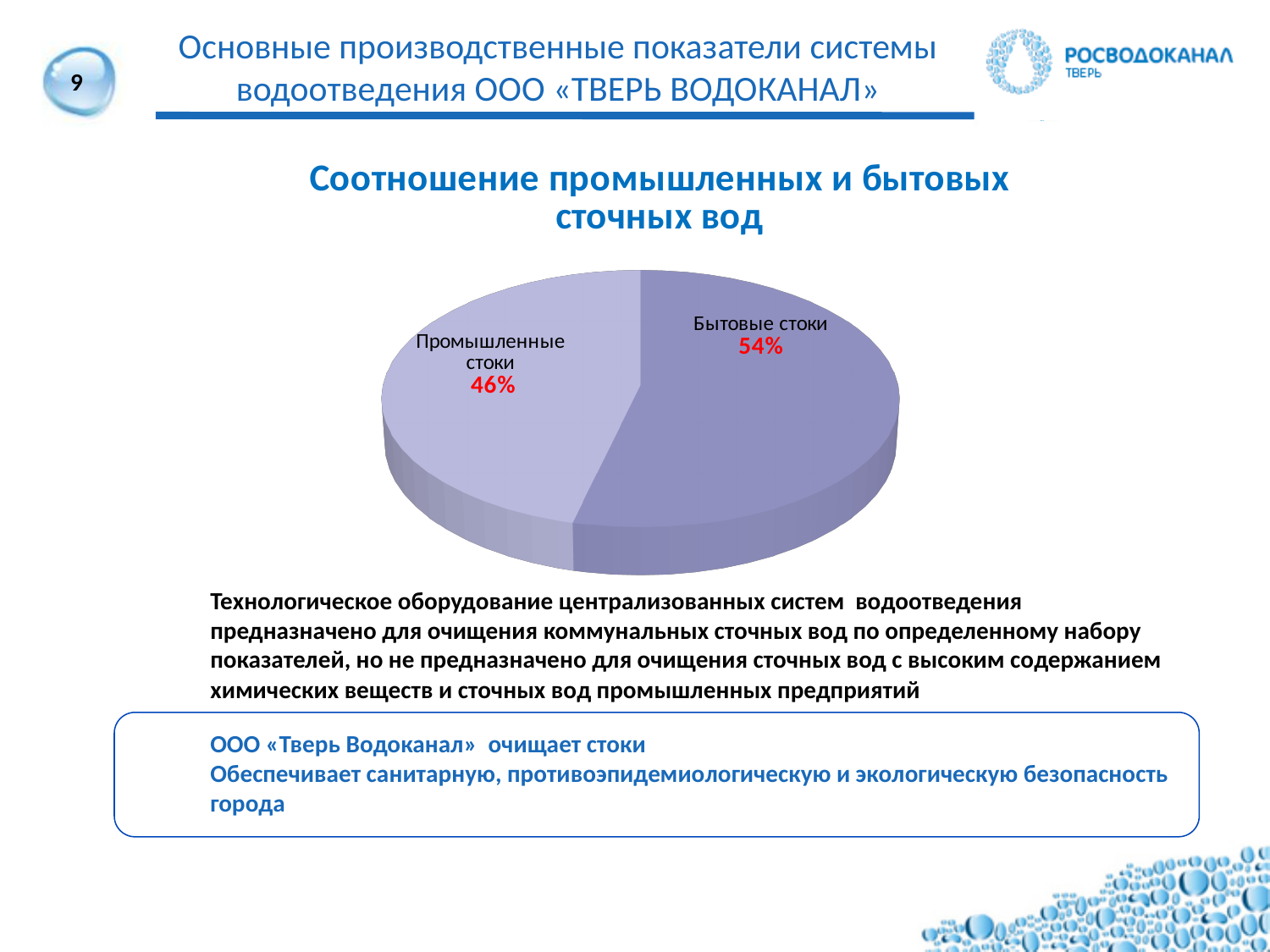
What is the total of the two slices shown in the pie chart? 100% Is the share for Промышленные стоки greater or less than 50%? less Which slice of the pie is the smallest? Промышленные стоки What kind of chart is shown on the slide? Pie chart Which slice of the pie is the largest? Бытовые стоки What is the difference in percentage points between Бытовые стоки and Промышленные стоки? 8 percentage points What share of the pie does Бытовые стоки represent? 54% What share of the pie does Промышленные стоки represent? 46% Which is larger: Бытовые стоки or Промышленные стоки? Бытовые стоки How many slices does the pie chart have? 2 What is the title of the chart? Соотношение промышленных и бытовых сточных вод